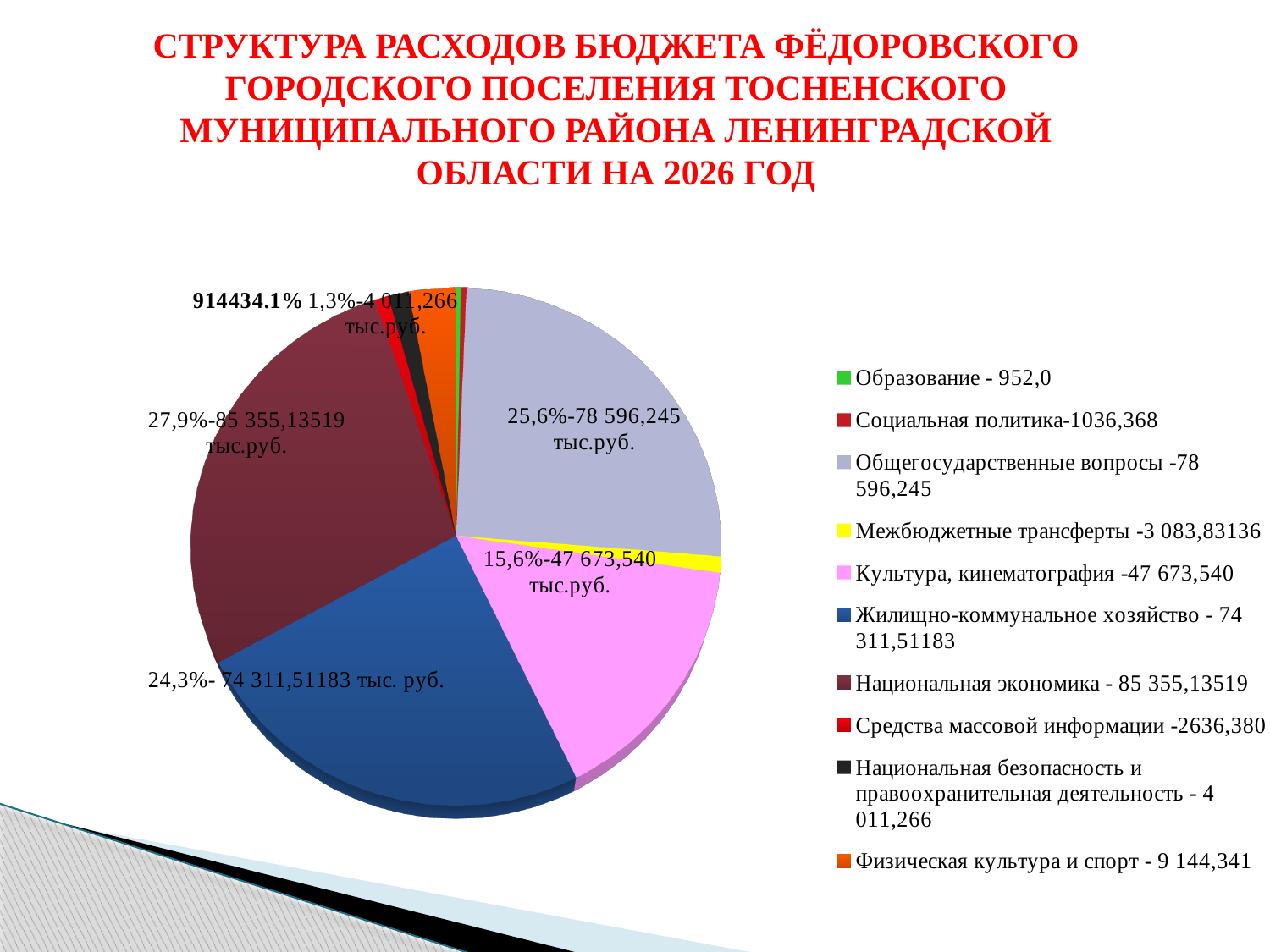
What is the difference between the values for Физическая культура и спорт and Национальная безопасность и правоохранительная деятельность? 5 133,075 What share of the pie does Национальная экономика represent, according to the data label? 27,9% What value is listed in the legend for Средства массовой информации? 2636,380 What colour is the slice for Межбюджетные трансферты? yellow Which category has the smallest slice of the pie chart? Образование What value is listed in the legend for Физическая культура и спорт? 9 144,341 Which is larger: Жилищно-коммунальное хозяйство or Культура, кинематография? Жилищно-коммунальное хозяйство Which category has the largest slice of the pie chart? Национальная экономика What share of the pie does Культура, кинематография represent, according to the data label? 15,6% What value is listed in the legend for Общегосударственные вопросы? 78 596,245 How many categories does the legend of the pie chart list? 10 What kind of chart is shown on the slide? pie chart